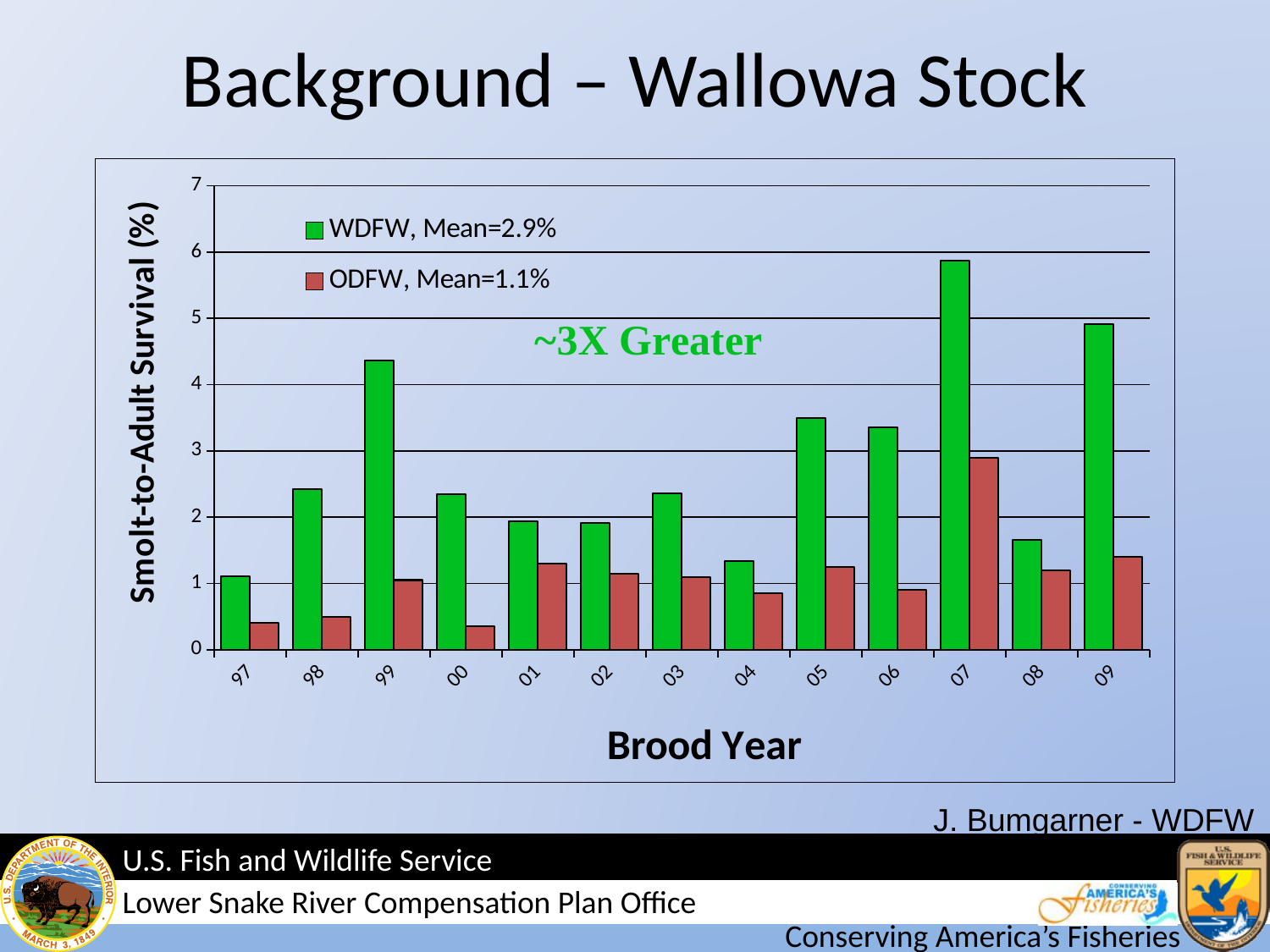
Is the WDFW value for brood year 07 greater or less than 5? greater Is the WDFW value for brood year 99 greater or less than 4? greater What is the title of the x axis? Brood Year How many series does the legend list? 2 What mean value does the legend give for WDFW? 2.9% What kind of chart is shown on the slide? bar chart How many brood years are shown on the x axis? 13 Which brood year has the highest WDFW smolt-to-adult survival? 07 Which brood year has the lowest WDFW smolt-to-adult survival? 97 Which brood year has the highest ODFW smolt-to-adult survival? 07 Which is larger, the WDFW value for brood year 99 or for brood year 09? 09